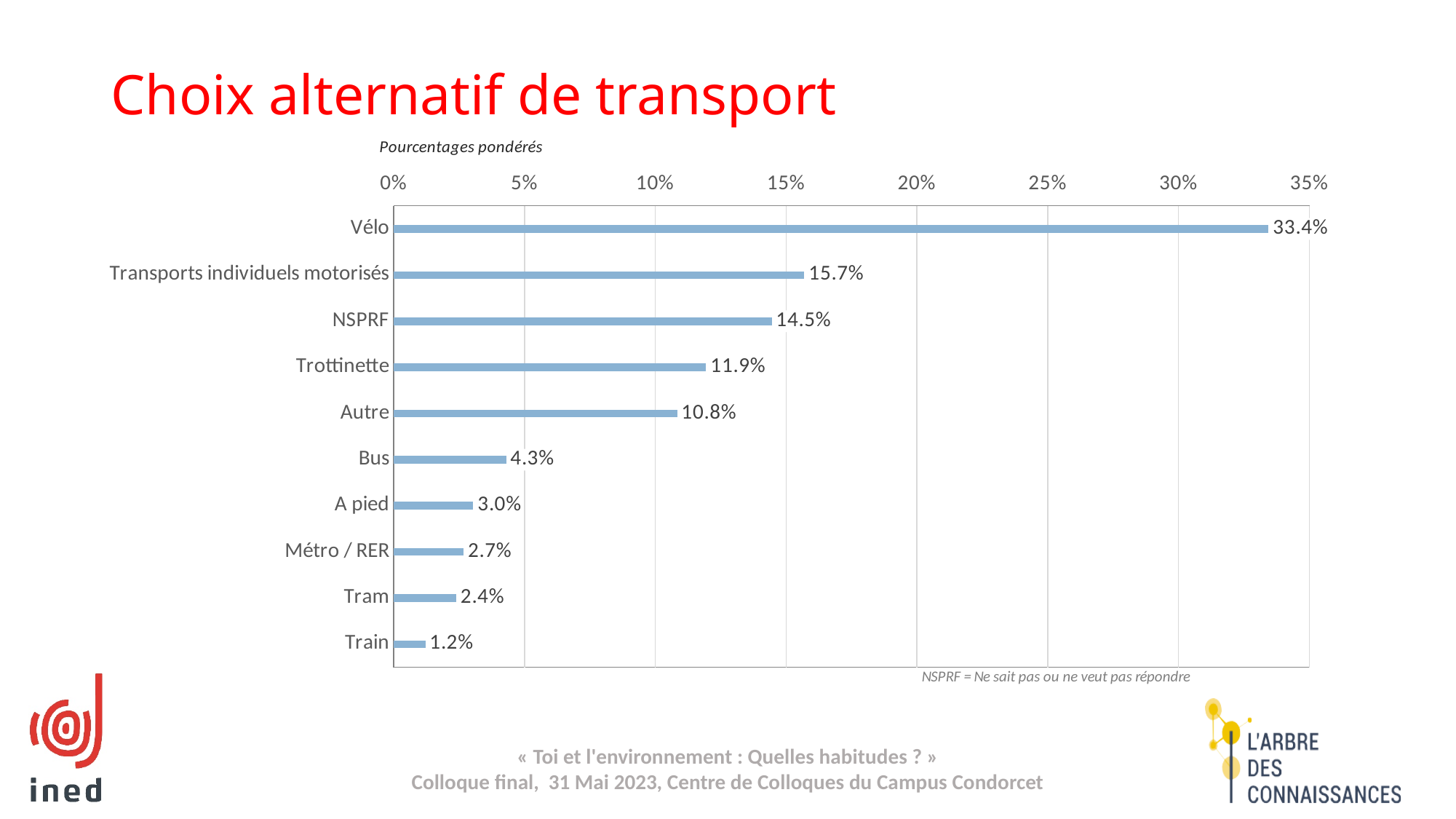
What is the value for Trottinette? 11.9% How many categories are shown in the chart? 10 Which is larger, the value for NSPRF or the value for Autre? NSPRF What is the value for Métro / RER? 2.7% Is the value for Transports individuels motorisés greater or less than 15%? greater Which category has the lowest value? Train What kind of chart is shown on the slide? Bar chart What is the value for Vélo? 33.4% What is the difference between the values for Vélo and Transports individuels motorisés? 17.7% What is the title of the slide? Choix alternatif de transport What is the difference between the values for Bus and Tram? 1.9% Which category has the highest value? Vélo